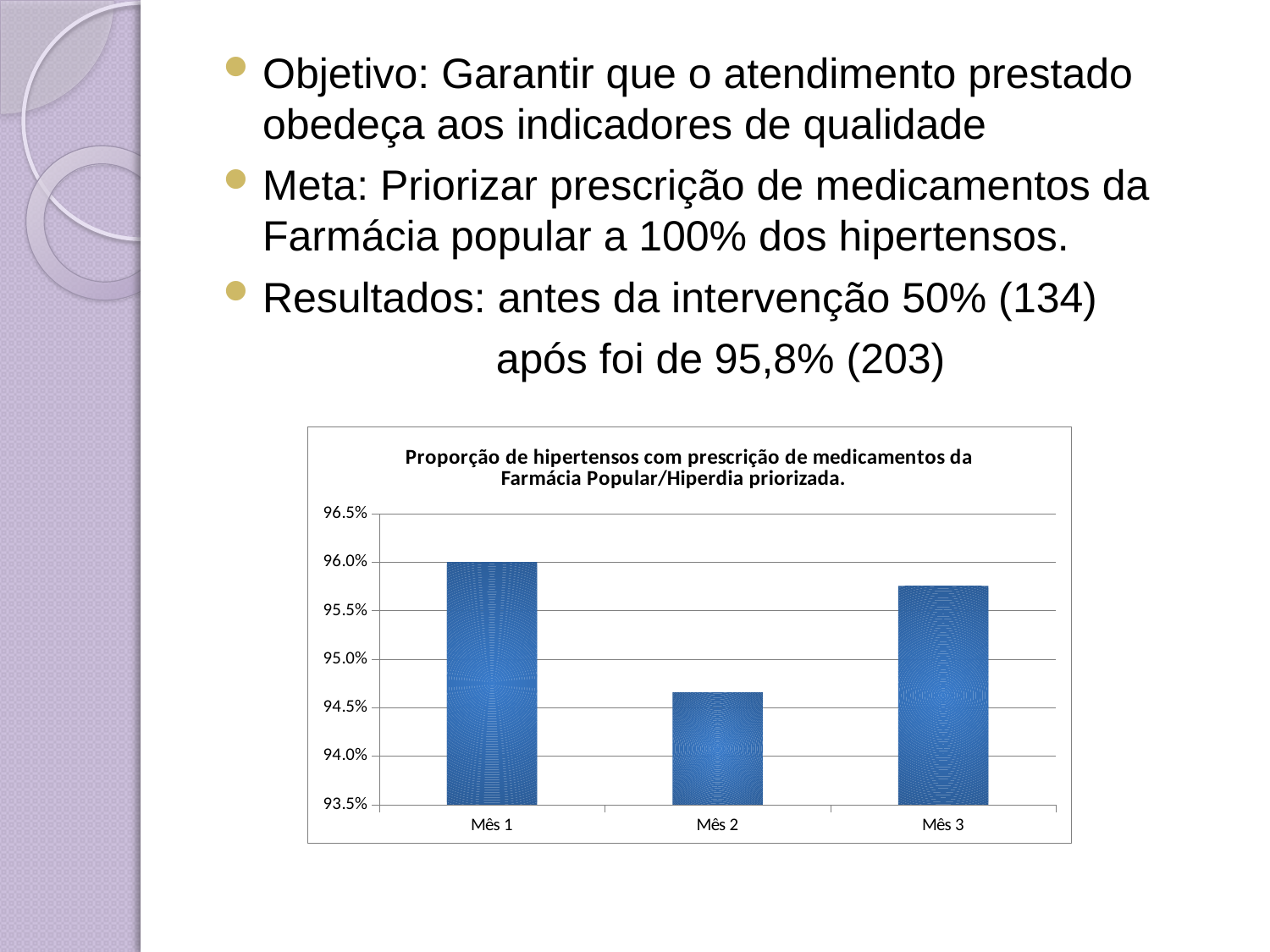
What type of chart is shown on the slide? bar chart Is the value for Mês 2 greater or less than 94.5%? greater Is the value for Mês 3 greater or less than 95.5%? greater What is the title of the chart? Proporção de hipertensos com prescrição de medicamentos da Farmácia Popular/Hiperdia priorizada. How many categories (months) are plotted in the chart? 3 Which is larger, the value for Mês 1 or the value for Mês 2? Mês 1 Which month has the highest proportion in the chart? Mês 1 Does the value rise or fall from Mês 1 to Mês 2? fall Which is larger, the value for Mês 3 or the value for Mês 2? Mês 3 Which month has the lowest proportion in the chart? Mês 2 Is the value for Mês 1 greater or less than 95.5%? greater